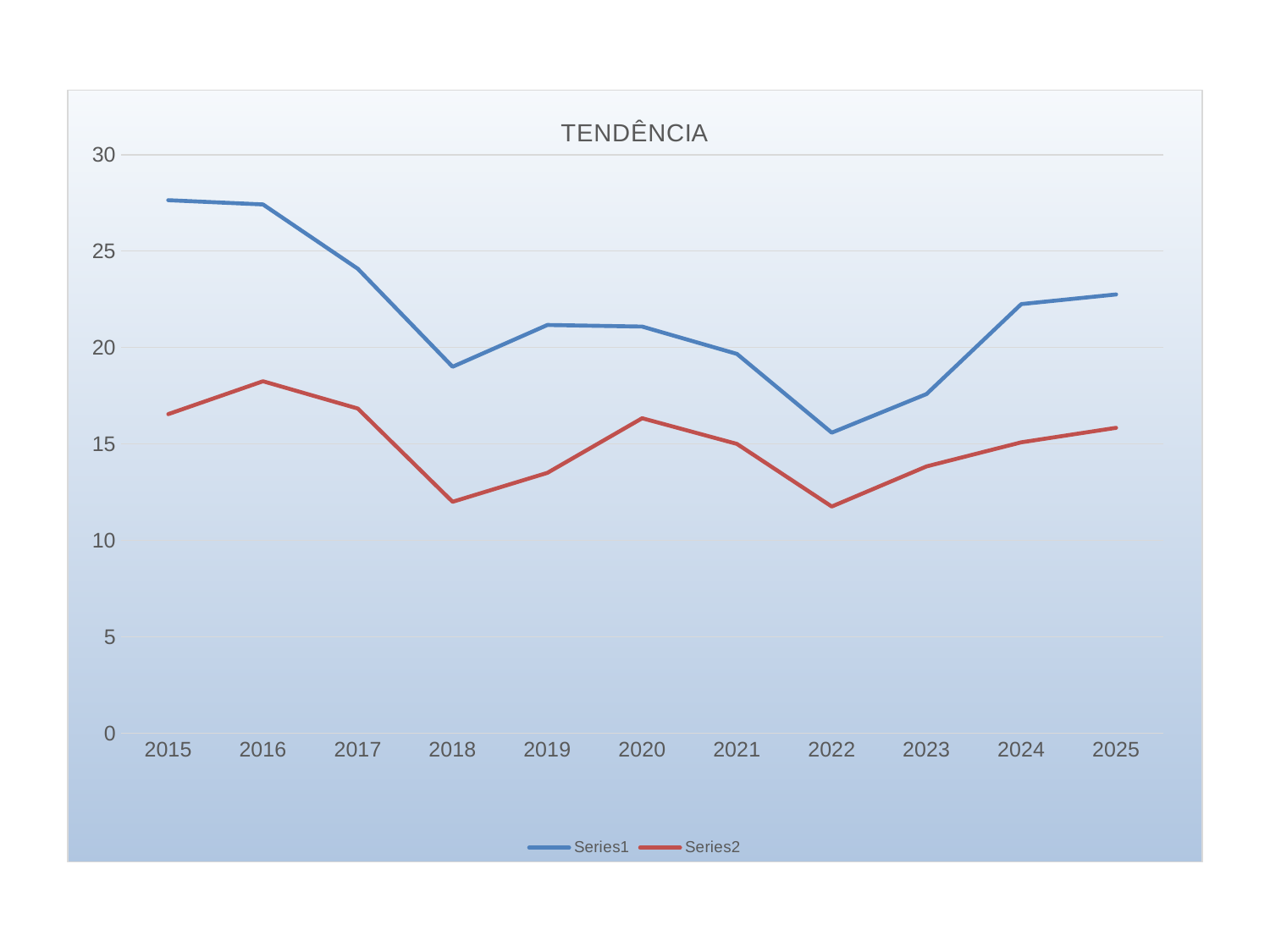
Is the value for Series1 in 2024 greater or less than 20? greater In which year does Series2 reach its highest value? 2016 Is the value for Series1 in 2015 greater or less than 25? greater Is the value for Series2 in 2018 greater or less than 15? less What is the title of the chart? TENDÊNCIA Which series has the larger value in 2020, Series1 or Series2? Series1 Does Series1 rise or fall from 2015 to 2018? fall How many years are shown on the x axis? 11 What kind of chart is shown on the slide? line chart In which year does Series1 reach its lowest value? 2022 How many series does the legend list? 2